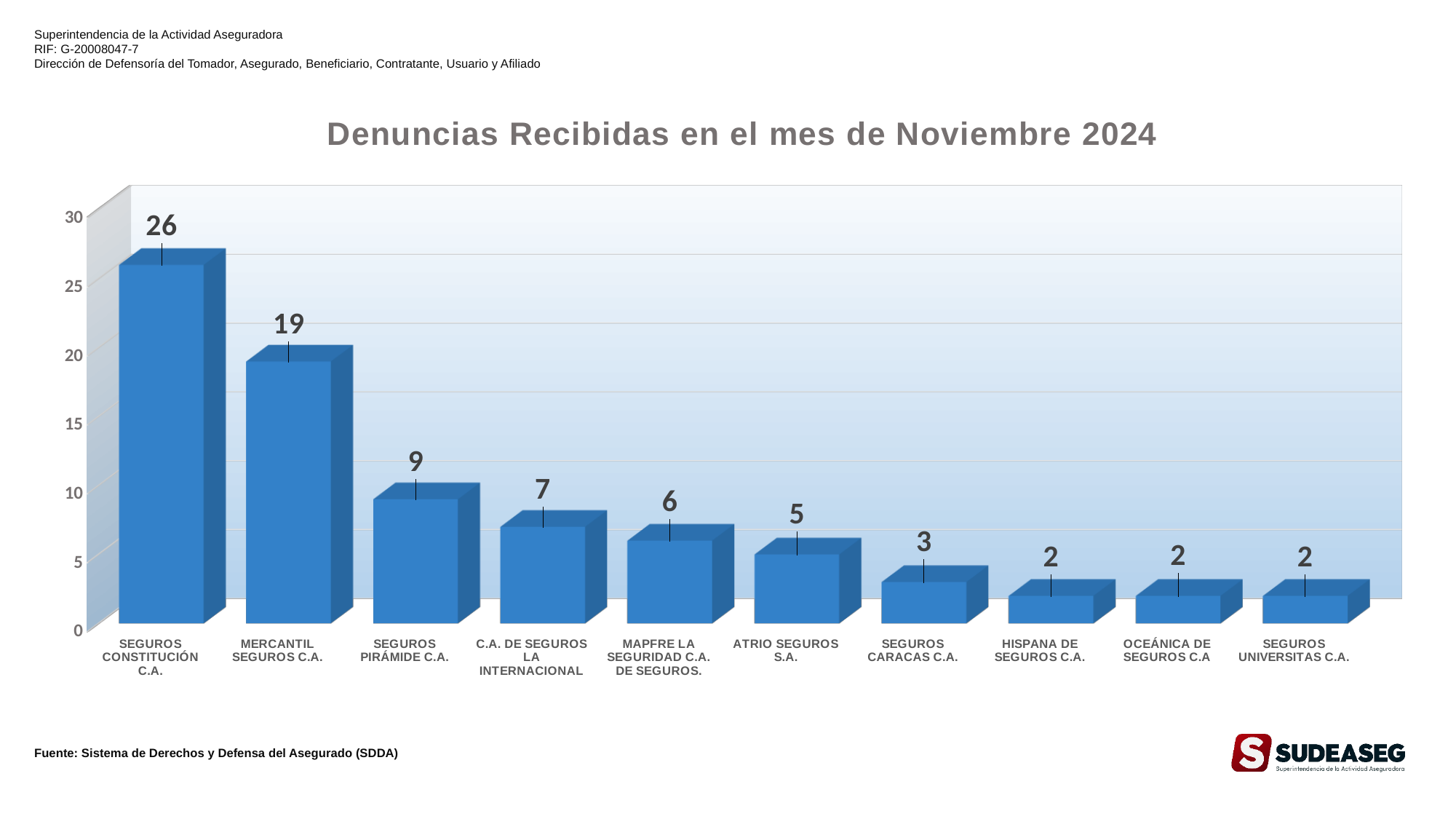
What is the value shown for MAPFRE LA SEGURIDAD C.A. DE SEGUROS.? 6 Do the values rise or fall from left to right along the x axis? fall What is the difference between the values for SEGUROS CONSTITUCIÓN C.A. and MERCANTIL SEGUROS C.A.? 7 What is the value shown for MERCANTIL SEGUROS C.A.? 19 How many companies are shown on the chart? 10 Which is larger, the value for C.A. DE SEGUROS LA INTERNACIONAL or the value for SEGUROS CARACAS C.A.? C.A. DE SEGUROS LA INTERNACIONAL How many denuncias were received for SEGUROS CONSTITUCIÓN C.A.? 26 What kind of chart is shown on the slide? bar chart Which company has the highest number of denuncias? SEGUROS CONSTITUCIÓN C.A. What is the difference between the values for SEGUROS PIRÁMIDE C.A. and ATRIO SEGUROS S.A.? 4 What is the title of the chart? Denuncias Recibidas en el mes de Noviembre 2024 Is the value for MERCANTIL SEGUROS C.A. greater or less than 15? greater